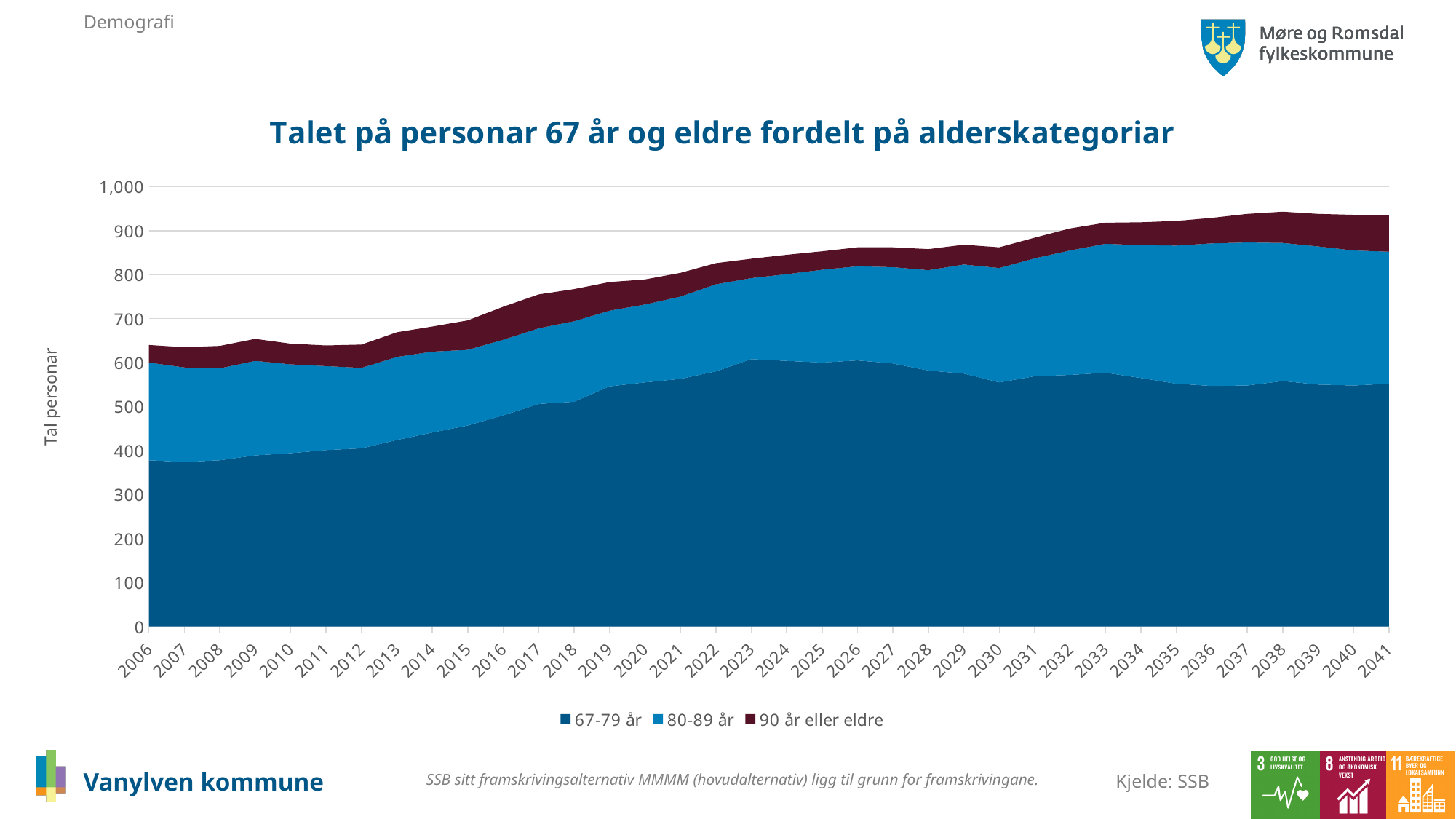
What is the label on the vertical axis? Tal personar Is the total of all three age groups in 2041 greater or less than 900? greater Is the value for the 67-79 år series in 2006 greater or less than 400? less Which age group has the smallest value in 2041? 90 år eller eldre Which age group has the largest value in 2041? 67-79 år What kind of chart is shown on the slide? Stacked area chart How many years are shown along the x axis? 36 How many series does the legend list? 3 Is the total of all three age groups in 2006 greater or less than 600? greater What is the title of the chart? Talet på personar 67 år og eldre fordelt på alderskategoriar Does the total number of persons 67 years and older rise or fall from 2006 to 2041? rise